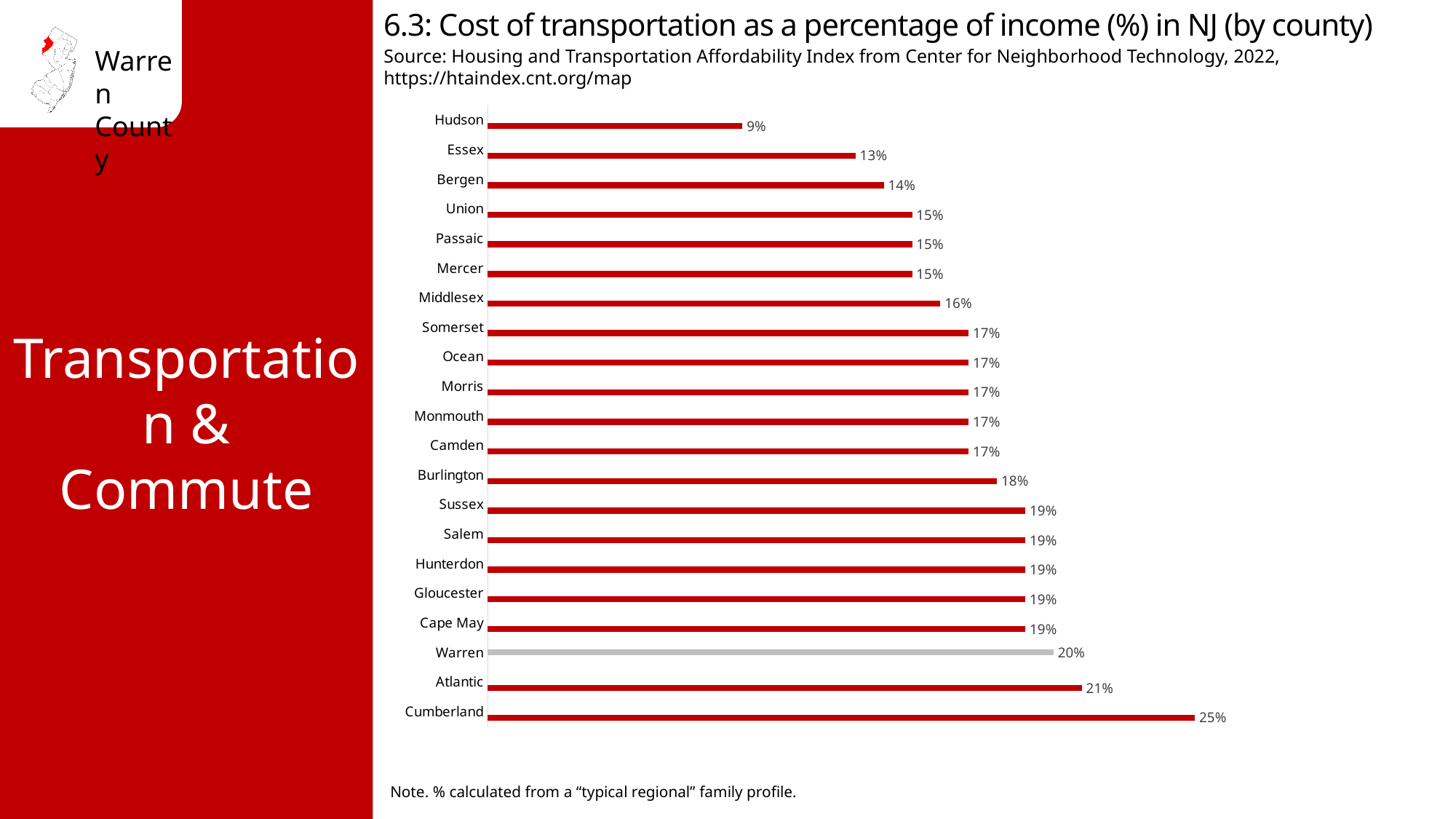
Which has a higher value, Warren or Bergen? Warren How many counties are shown in the chart? 21 Which county's bar is shown in grey rather than red? Warren What is the difference between the values for Cumberland and Hudson? 16% What is the cost of transportation as a percentage of income for Warren county? 20% What is the difference between the values for Atlantic and Warren? 1% Which county has the highest cost of transportation as a percentage of income? Cumberland What kind of chart is shown on the slide? Bar chart What is the value shown for Middlesex county? 16% What is the value shown for Hudson county? 9% Which county has the lowest cost of transportation as a percentage of income? Hudson Which has a higher value, Essex or Burlington? Burlington